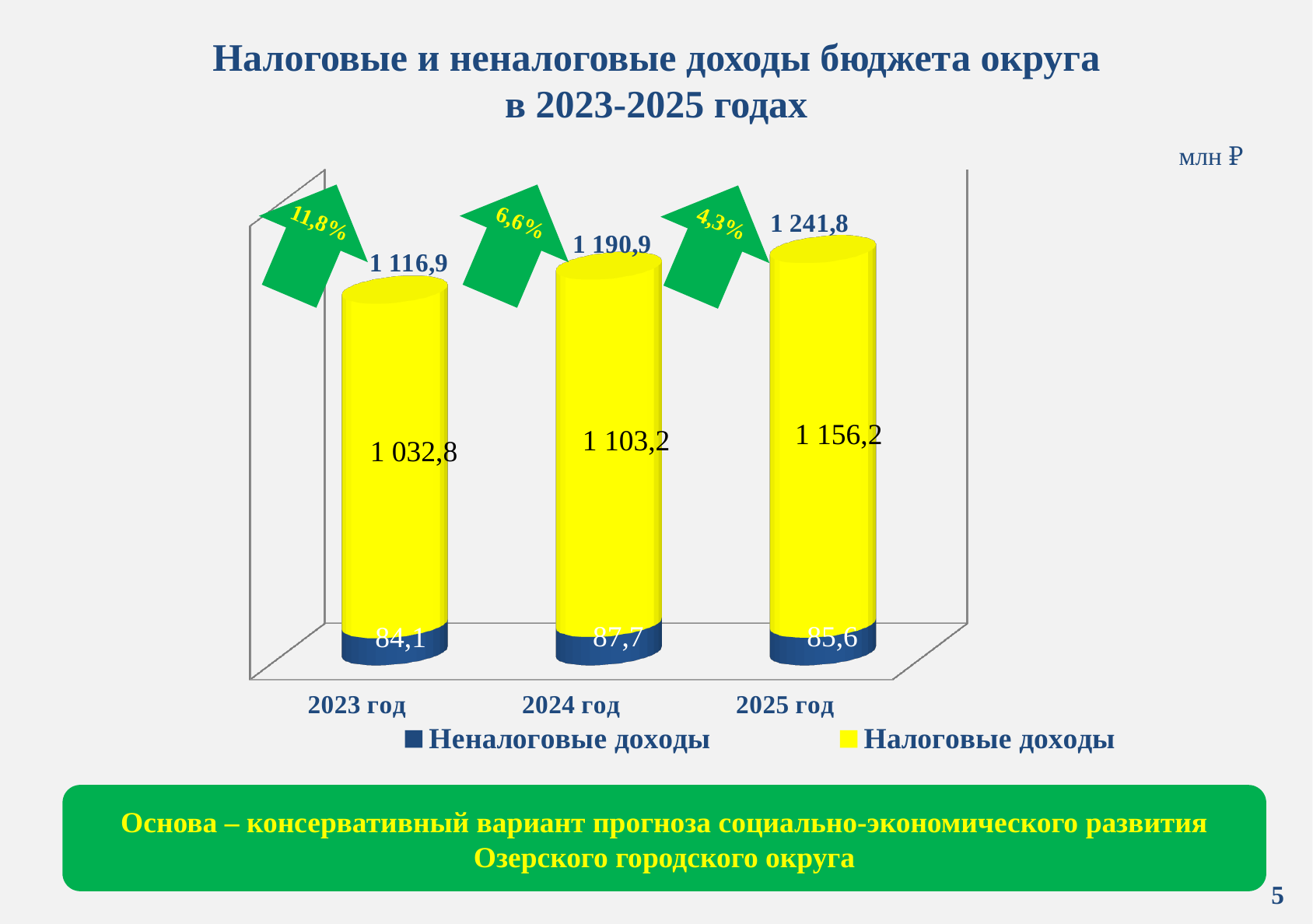
Which year has the highest value of Неналоговые доходы? 2024 год Which year has the lowest value of Налоговые доходы? 2023 год What is the total of the stacked bar for 2025 год? 1 241,8 Which is larger: Неналоговые доходы in 2025 год or in 2023 год? 2025 год What is the value of Неналоговые доходы for 2023 год? 84,1 What is the difference between Налоговые доходы in 2025 год and 2024 год? 53,0 What is the total of the stacked bar for 2023 год? 1 116,9 What is the value of Налоговые доходы for 2025 год? 1 156,2 How many series does the legend list? 2 How many years are shown on the x axis? 3 What is the value of Налоговые доходы for 2024 год? 1 103,2 What kind of chart is shown on the slide? Stacked bar chart